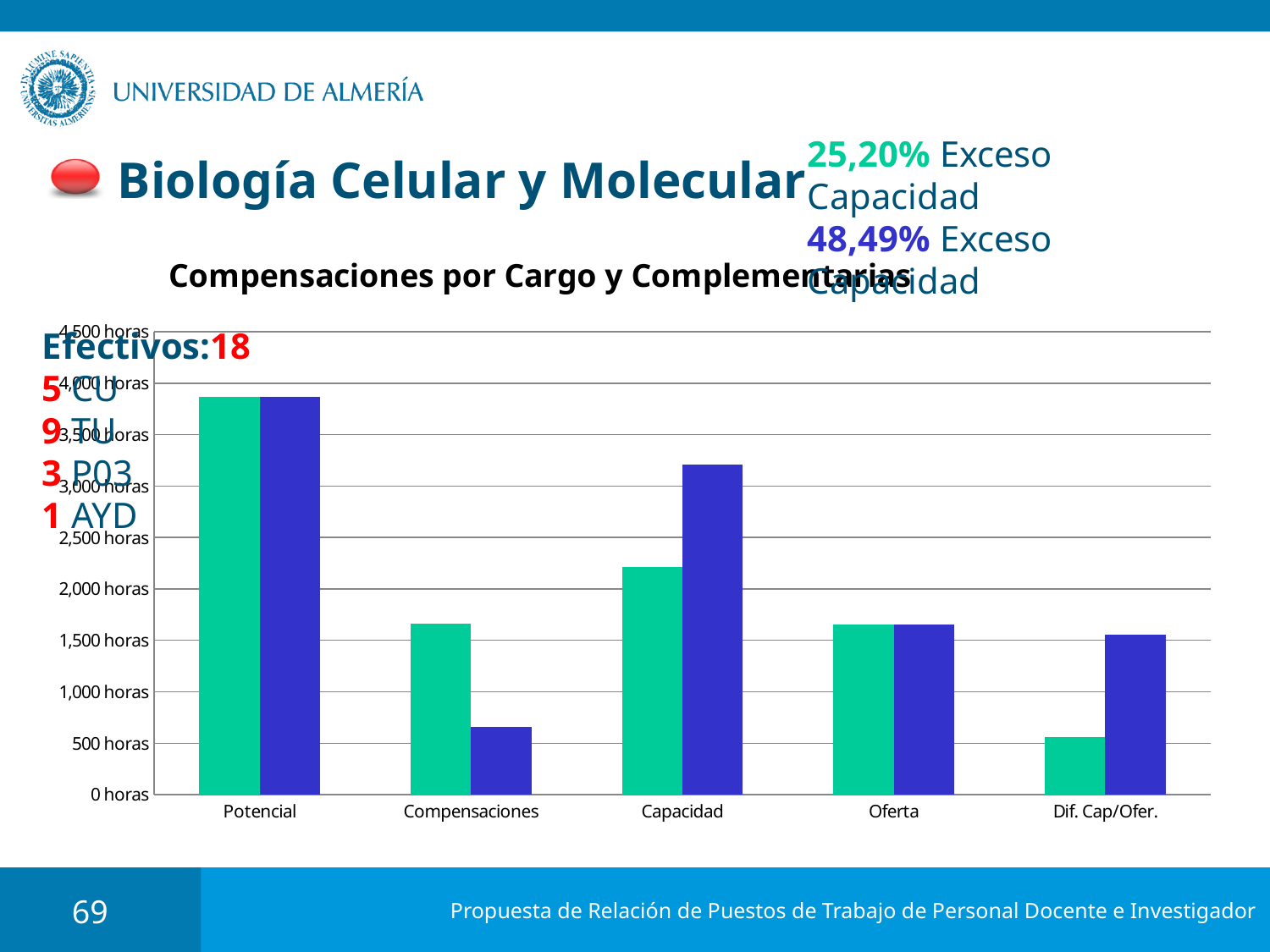
Which category has the shortest green bar? Dif. Cap/Ofer. What is the title of the chart? Compensaciones por Cargo y Complementarias Is the green bar for Capacidad greater or less than 2,000 horas? greater Which category has the shortest blue bar? Compensaciones Is the green bar for Potencial greater or less than 3,500 horas? greater For Compensaciones, which bar is taller, the green one or the blue one? the green one What kind of chart is shown on the slide? bar chart How many categories are shown on the x axis of the chart? 5 Which category has the tallest green bar? Potencial For Dif. Cap/Ofer., which bar is taller, the green one or the blue one? the blue one Is the blue bar for Capacidad greater or less than 3,000 horas? greater